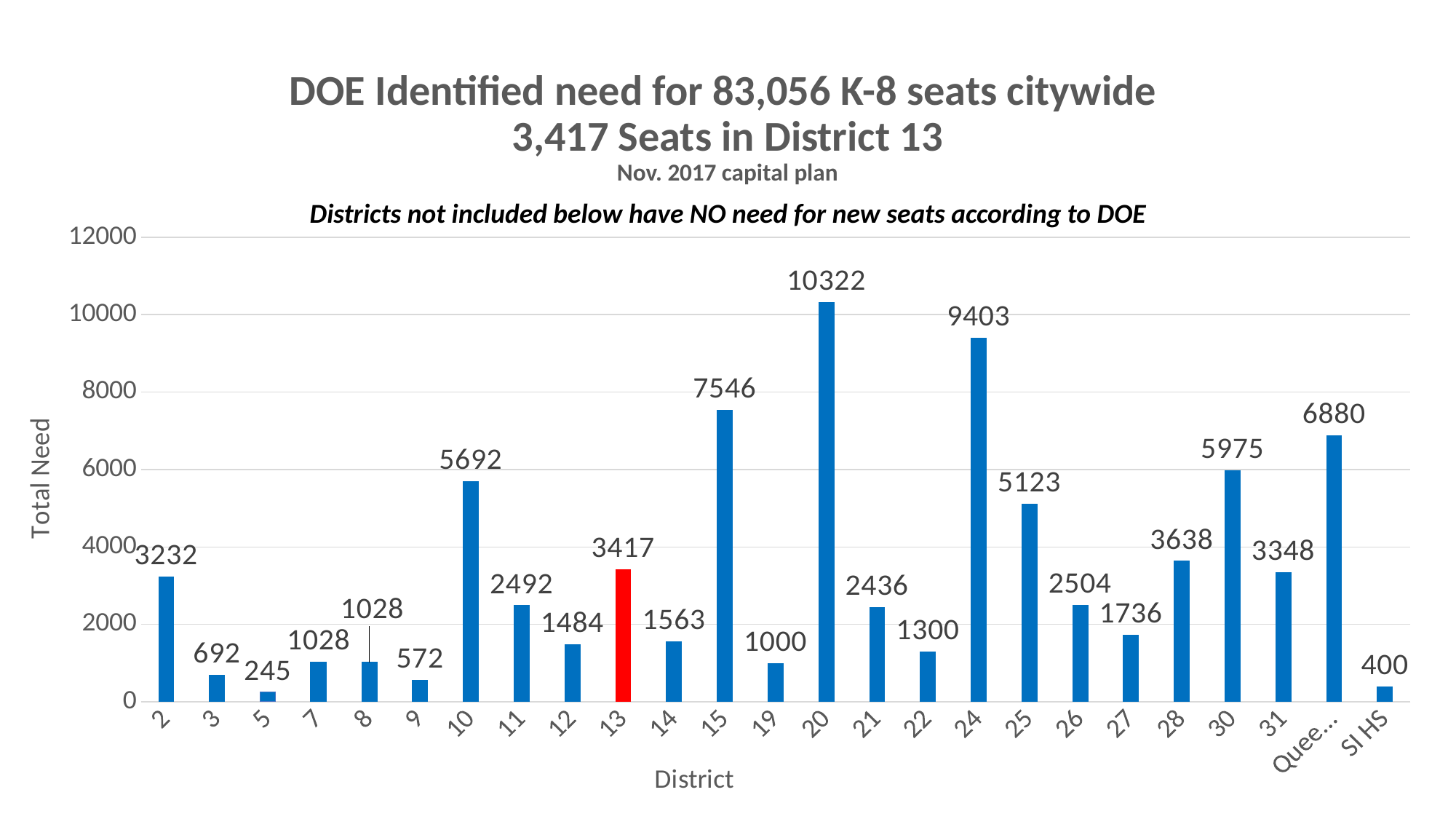
Which district has the highest total need? 20 What is the difference in total need between District 13 and District 10? 2275 Which bar is highlighted in red? District 13 What is the total need for District 15? 7546 Which district has the lowest total need? 5 What is the total need for District 30? 5975 Is the value for District 25 greater or less than 4000? greater Which has a larger total need, District 28 or District 31? District 28 What kind of chart is shown on the slide? Bar chart How many districts (bars) are shown on the chart? 25 What is the total need for District 13? 3417 What is the difference in total need between District 20 and District 24? 919